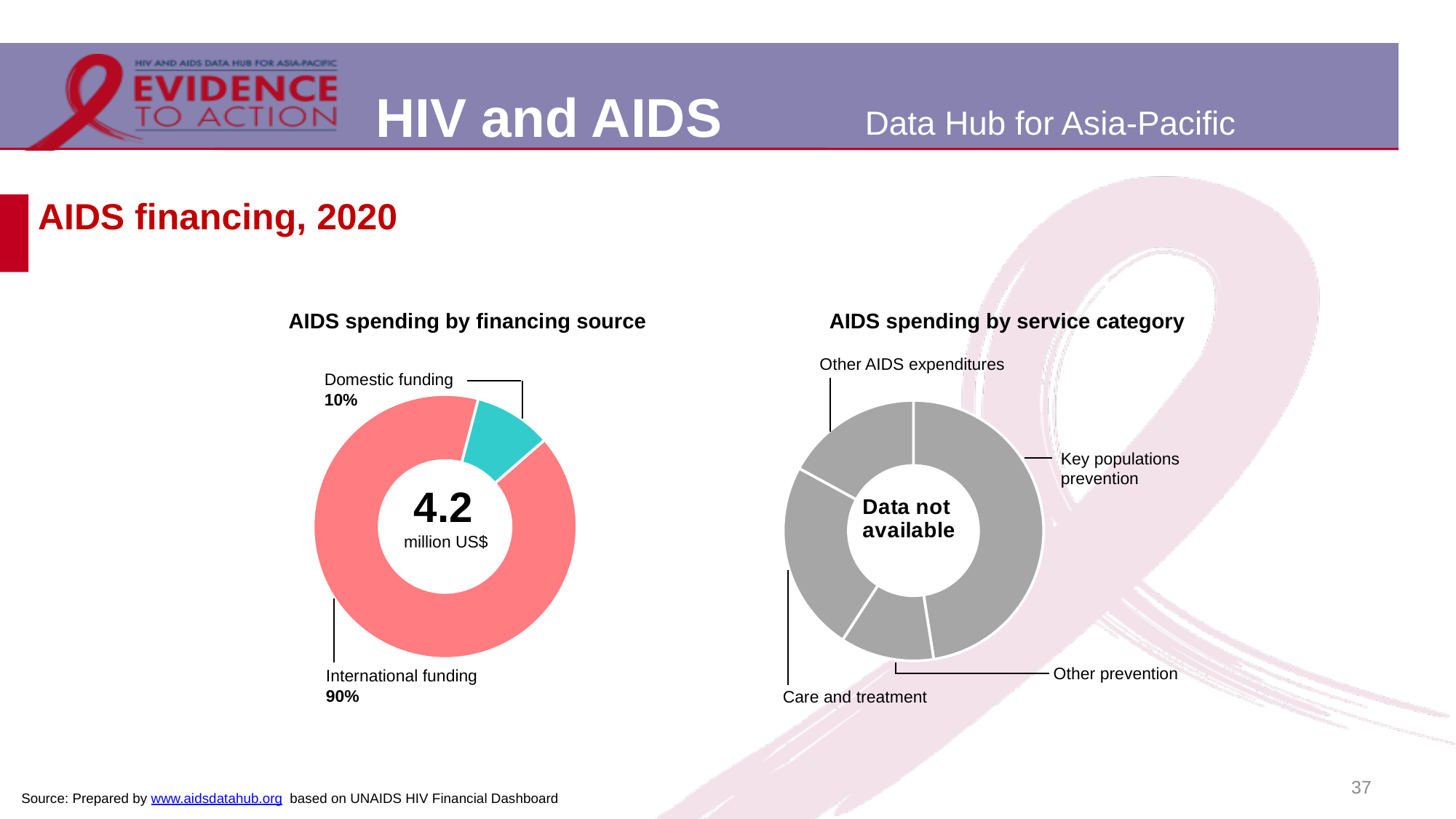
In the 'AIDS spending by financing source' chart, which financing source has the largest share? International funding What text appears in the centre of the 'AIDS spending by service category' chart? Data not available In the 'AIDS spending by financing source' chart, what share of spending comes from International funding? 90% How many service categories are labelled in the 'AIDS spending by service category' chart? 4 In the 'AIDS spending by financing source' chart, what total amount is shown in the centre of the donut? 4.2 million US$ In the 'AIDS spending by financing source' chart, what share of spending comes from Domestic funding? 10% What type of chart is the 'AIDS spending by financing source' chart? Donut (pie) chart In the 'AIDS spending by financing source' chart, what colour is the Domestic funding slice? Teal In the 'AIDS spending by financing source' chart, what is the difference in percentage points between International funding and Domestic funding? 80 percentage points In the 'AIDS spending by financing source' chart, which is larger: Domestic funding or International funding? International funding In the 'AIDS spending by financing source' chart, which financing source has the smallest share? Domestic funding How many financing sources are shown in the 'AIDS spending by financing source' chart? 2